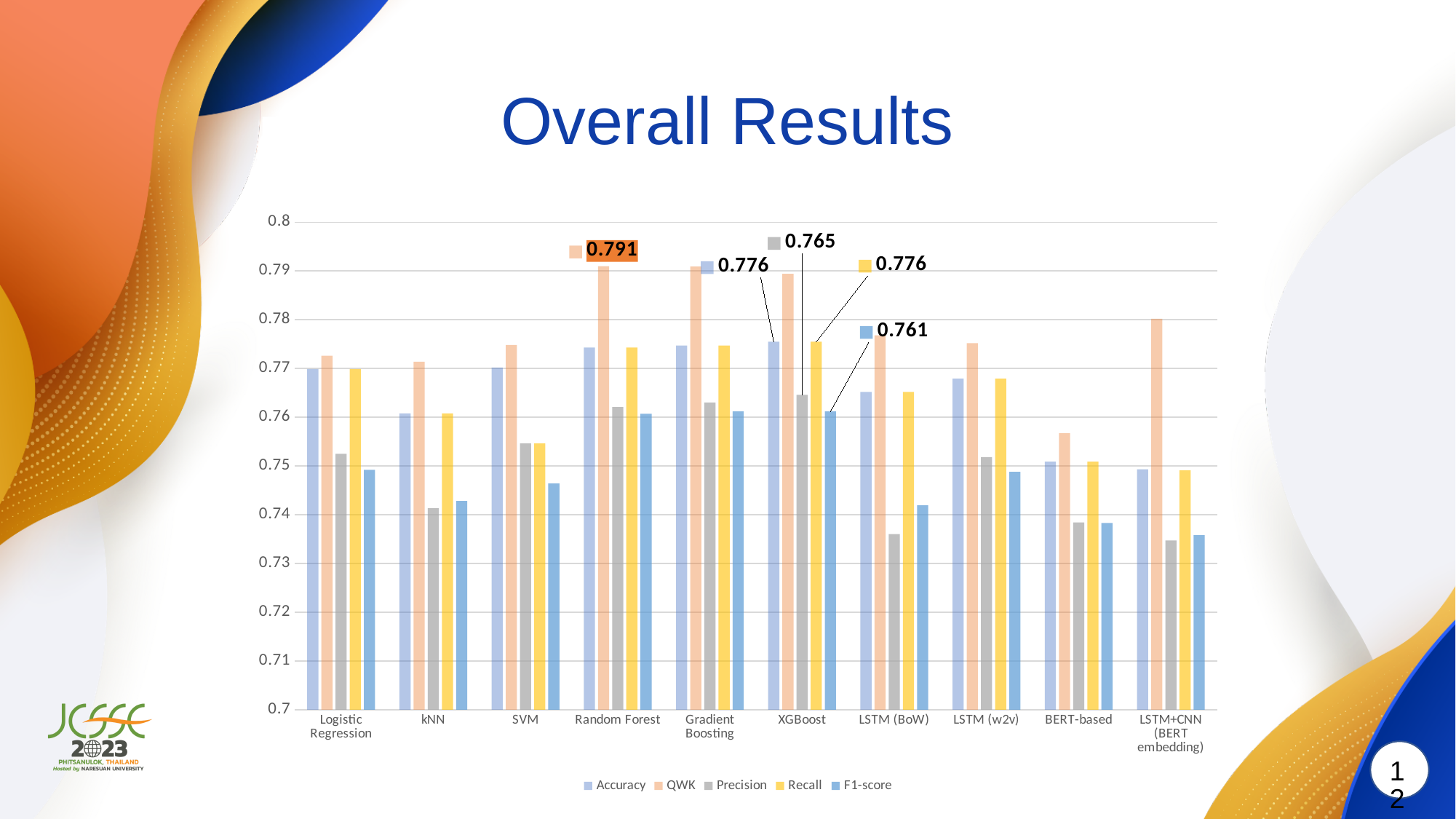
What is the difference between the Accuracy and Precision values for XGBoost? 0.011 What is the Precision value for XGBoost? 0.765 How many models are shown on the x axis? 10 Is the Precision value for LSTM (BoW) greater or less than 0.74? less Which model has the lowest QWK value? BERT-based What type of chart is shown on the slide? bar chart What is the QWK value for Random Forest? 0.791 Which is larger: the QWK value for Random Forest or the Accuracy value for XGBoost? QWK for Random Forest What is the F1-score value for XGBoost? 0.761 What is the difference between the Recall and F1-score values for XGBoost? 0.015 What is the Accuracy value for XGBoost? 0.776 How many series does the legend list? 5